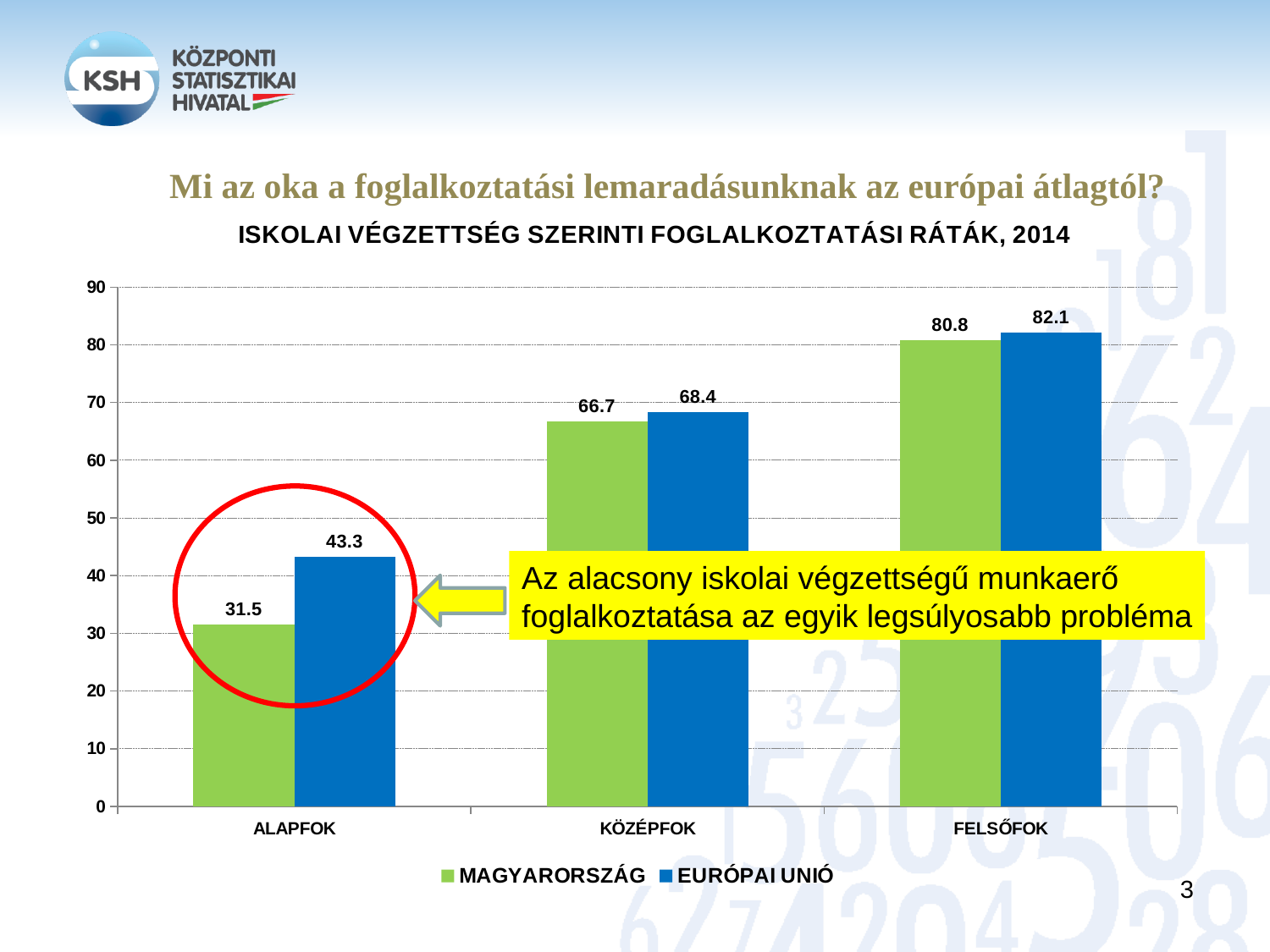
Which is larger in the Középfok category, Magyarország or Európai Unió? Európai Unió What kind of chart is shown on the slide? Bar chart What is the difference between the Európai Unió and Magyarország values in the Alapfok category? 11.8 What is the employment rate for Magyarország in the Alapfok category? 31.5 Which category has the lowest value for Magyarország? Alapfok What is the employment rate for Európai Unió in the Felsőfok category? 82.1 Which category has the highest value for Európai Unió? Felsőfok What is the difference between the Európai Unió and Magyarország values in the Felsőfok category? 1.3 How many categories are shown on the x axis? 3 How many series does the legend list? 2 What is the value for Magyarország in the Középfok category? 66.7 Do the Magyarország values rise or fall from Alapfok to Felsőfok? Rise